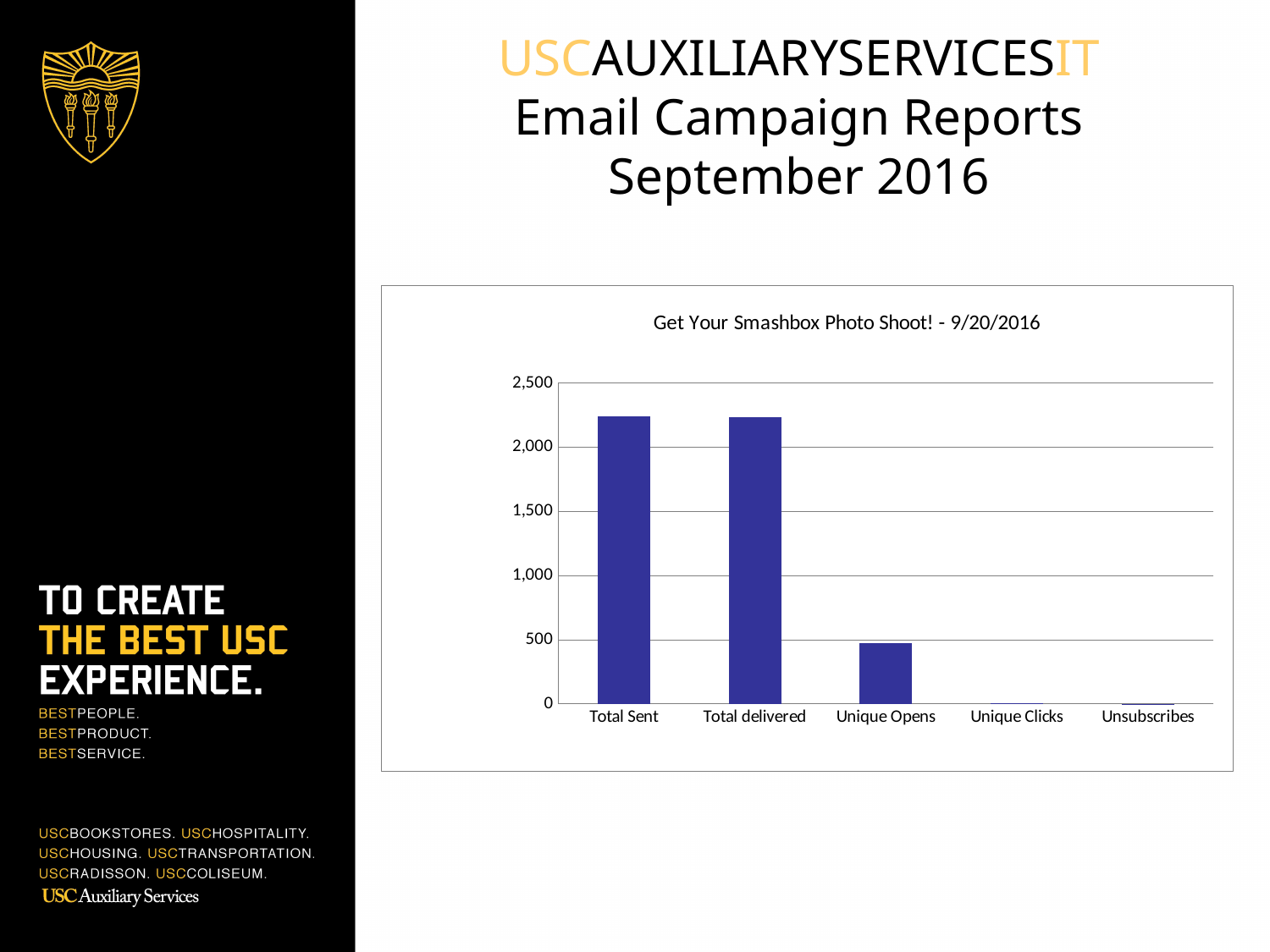
What is the title of the chart? Get Your Smashbox Photo Shoot! - 9/20/2016 Is the value for Total delivered greater or less than 2,000? greater Do the values generally rise or fall moving from left to right along the x axis? fall What kind of chart is shown on the slide? bar chart Which is larger, the value for Total Sent or the value for Unique Opens? Total Sent How many categories are shown on the x axis of the chart? 5 Is the value for Unique Opens greater or less than 1,000? less Is the value for Total Sent greater or less than 2,500? less What is the label of the first category on the x axis? Total Sent Which is larger, the value for Total delivered or the value for Unsubscribes? Total delivered